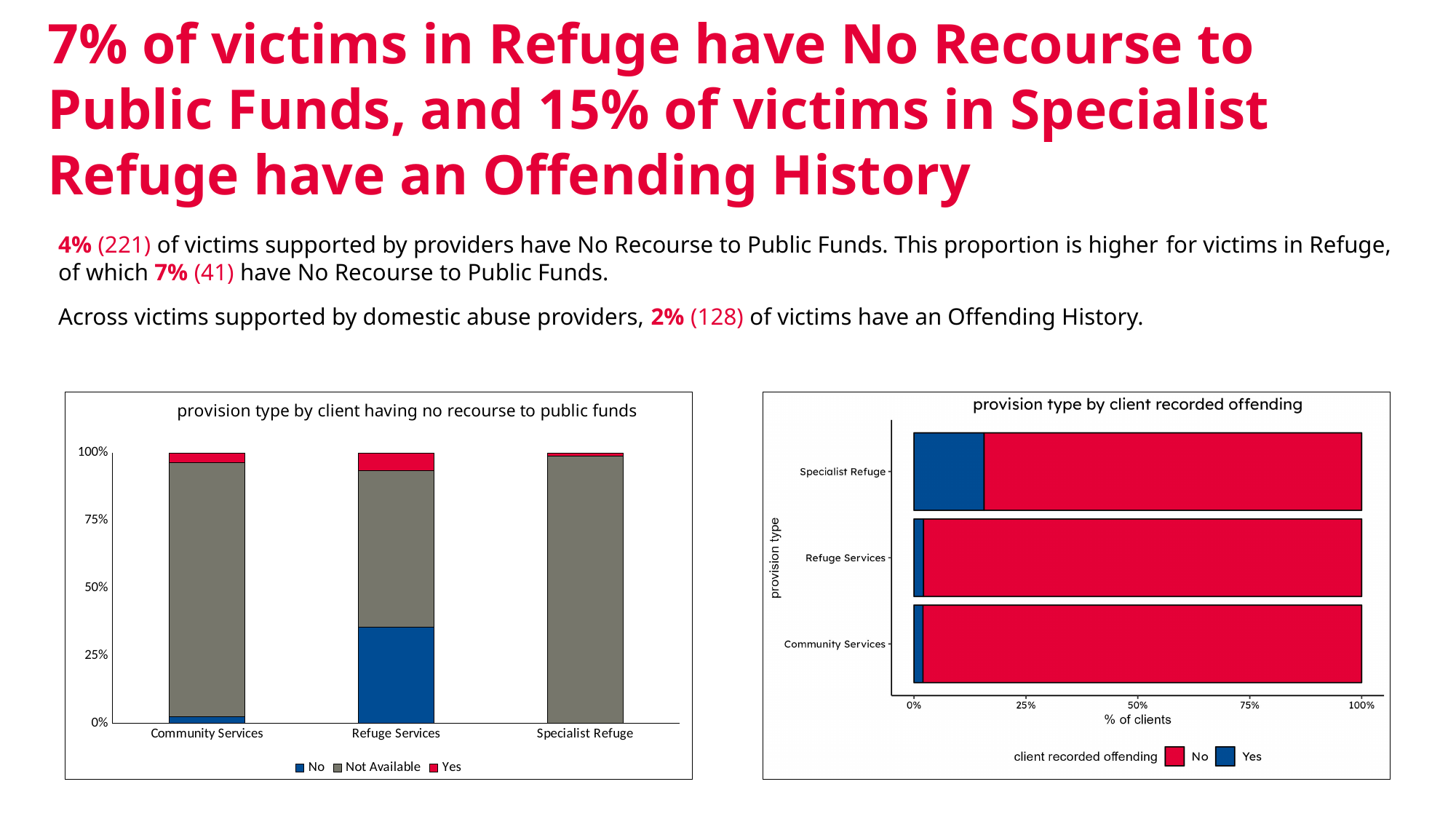
What is the x-axis label of the right chart, 'provision type by client recorded offending'? % of clients In the left chart, 'provision type by client having no recourse to public funds', which provision type has the largest 'No' segment? Refuge Services What kind of chart is the left chart, 'provision type by client having no recourse to public funds'? Stacked bar chart In the left chart, 'provision type by client having no recourse to public funds', is the 'Not Available' segment larger for Community Services or Refuge Services? Community Services What kind of chart is the right chart, 'provision type by client recorded offending'? Stacked bar chart How many provision type categories are shown in the left chart, 'provision type by client having no recourse to public funds'? 3 How many series does the legend of the left chart, 'provision type by client having no recourse to public funds', list? 3 In the right chart, 'provision type by client recorded offending', is the 'Yes' segment for Specialist Refuge greater or less than 25%? less In the left chart, 'provision type by client having no recourse to public funds', is the 'No' segment for Refuge Services greater or less than 25%? greater In the right chart, 'provision type by client recorded offending', is the 'No' segment for Community Services greater or less than 75%? greater In the right chart, 'provision type by client recorded offending', which provision type has the largest 'Yes' segment? Specialist Refuge How many series does the legend of the right chart, 'provision type by client recorded offending', list? 2